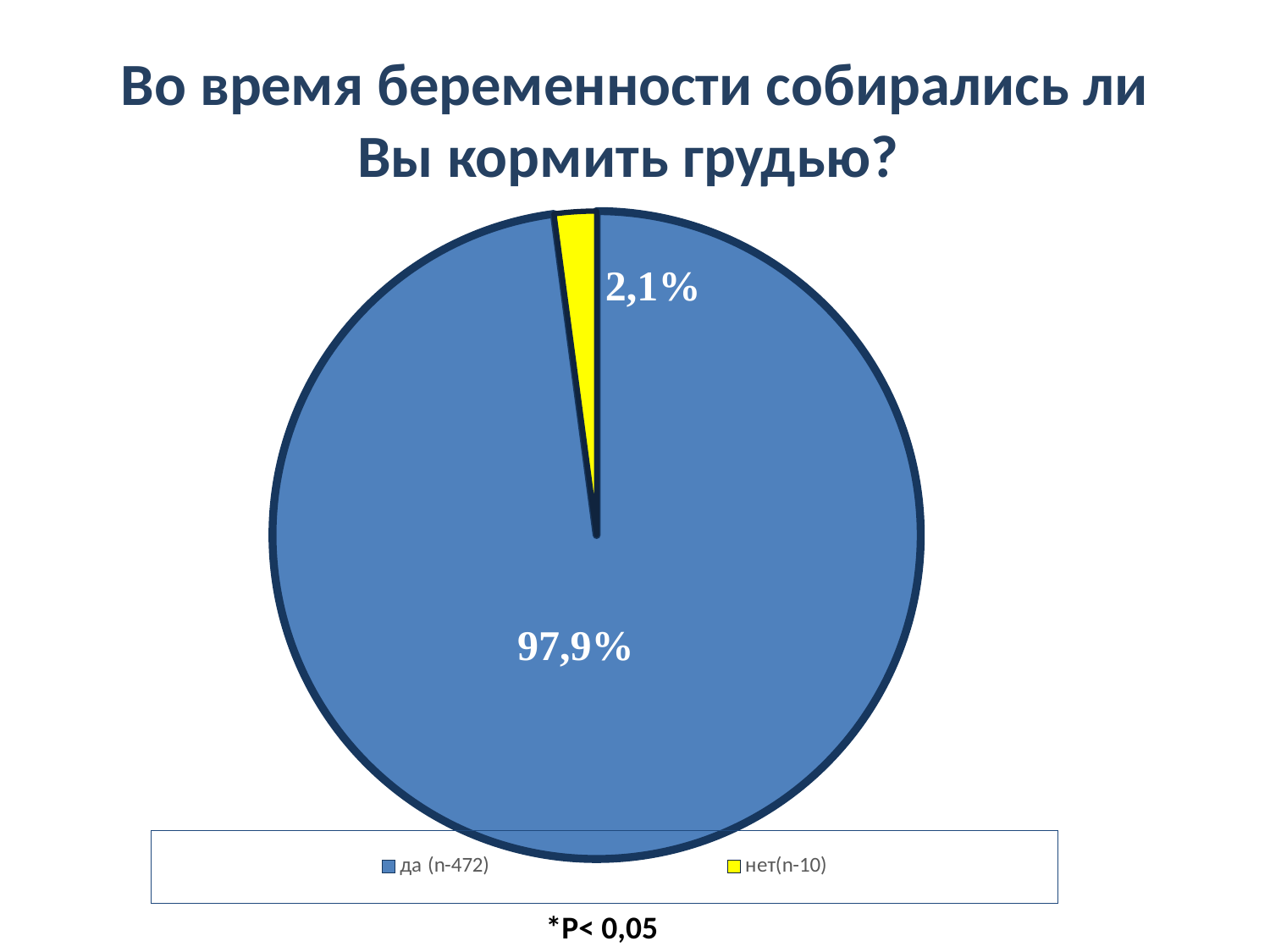
How many entries does the legend list? 2 Which category has the smallest slice of the pie? нет(n-10) How many respondents answered "да" according to the legend? 472 Which category has the largest slice of the pie? да (n-472) How many slices does the pie chart have? 2 What share of the pie does the "нет(n-10)" slice represent? 2,1% What kind of chart is shown on the slide? pie chart Which slice is larger, "да (n-472)" or "нет(n-10)"? да (n-472) What is the title of the chart? Во время беременности собирались ли Вы кормить грудью? What colour is the "нет(n-10)" slice? yellow What share of the pie does the "да (n-472)" slice represent? 97,9% What is the difference in percentage points between the "да" slice and the "нет" slice? 95,8